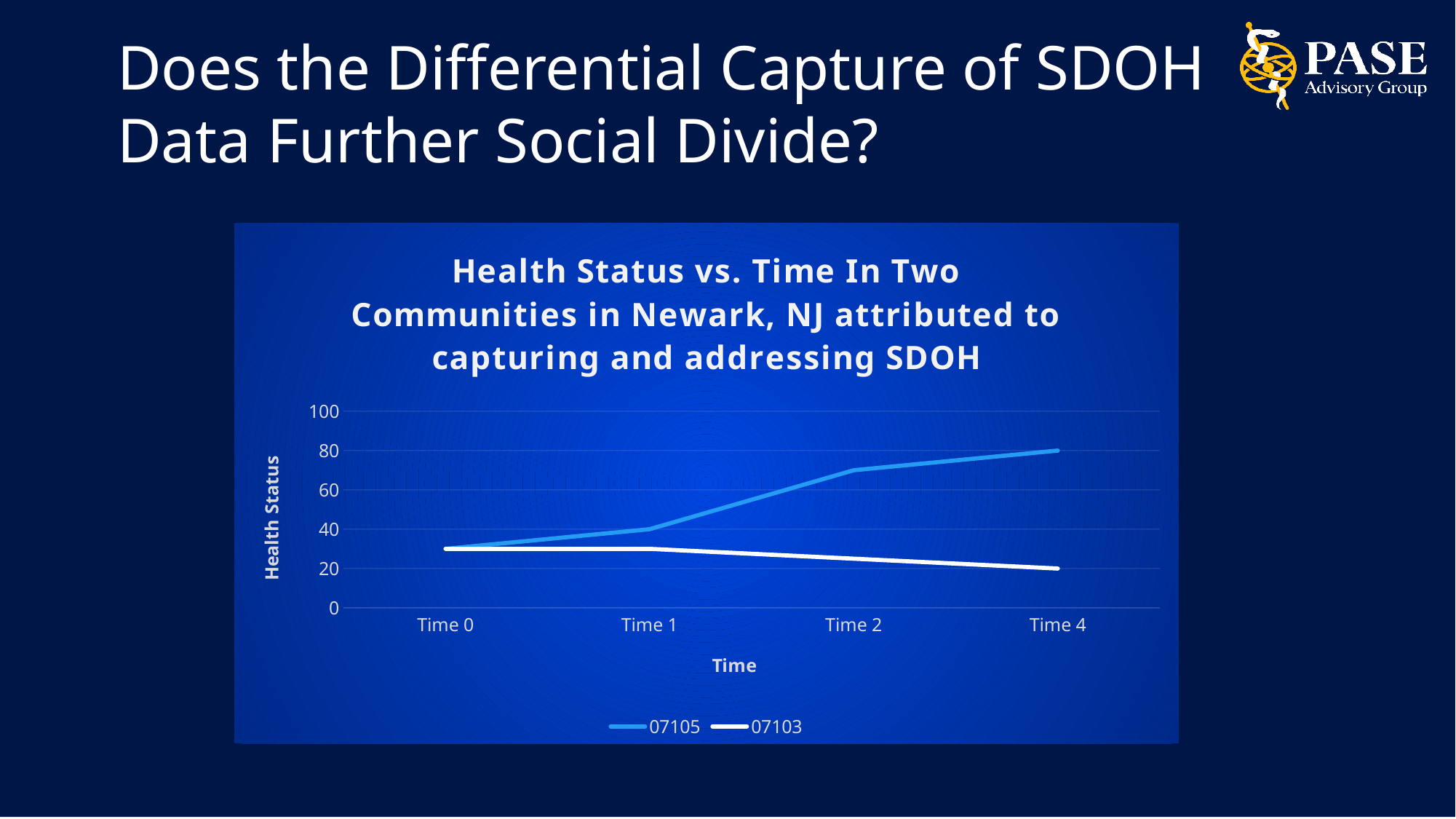
At Time 4, which series has the higher health status, 07105 or 07103? 07105 Does the 07103 series rise or fall from Time 0 to Time 4? fall What is the health status value for 07103 at Time 4? 20 Does the 07105 series rise or fall from Time 0 to Time 4? rise Is the value for 07103 at Time 2 greater or less than 40? less How many time points are plotted along the x axis? 4 How many series does the legend list? 2 At which time point does the 07105 series reach its highest value? Time 4 What is the label on the y axis of the chart? Health Status What is the health status value for 07105 at Time 4? 80 Is the value for 07105 at Time 2 greater or less than 60? greater What kind of chart is shown on the slide? line chart